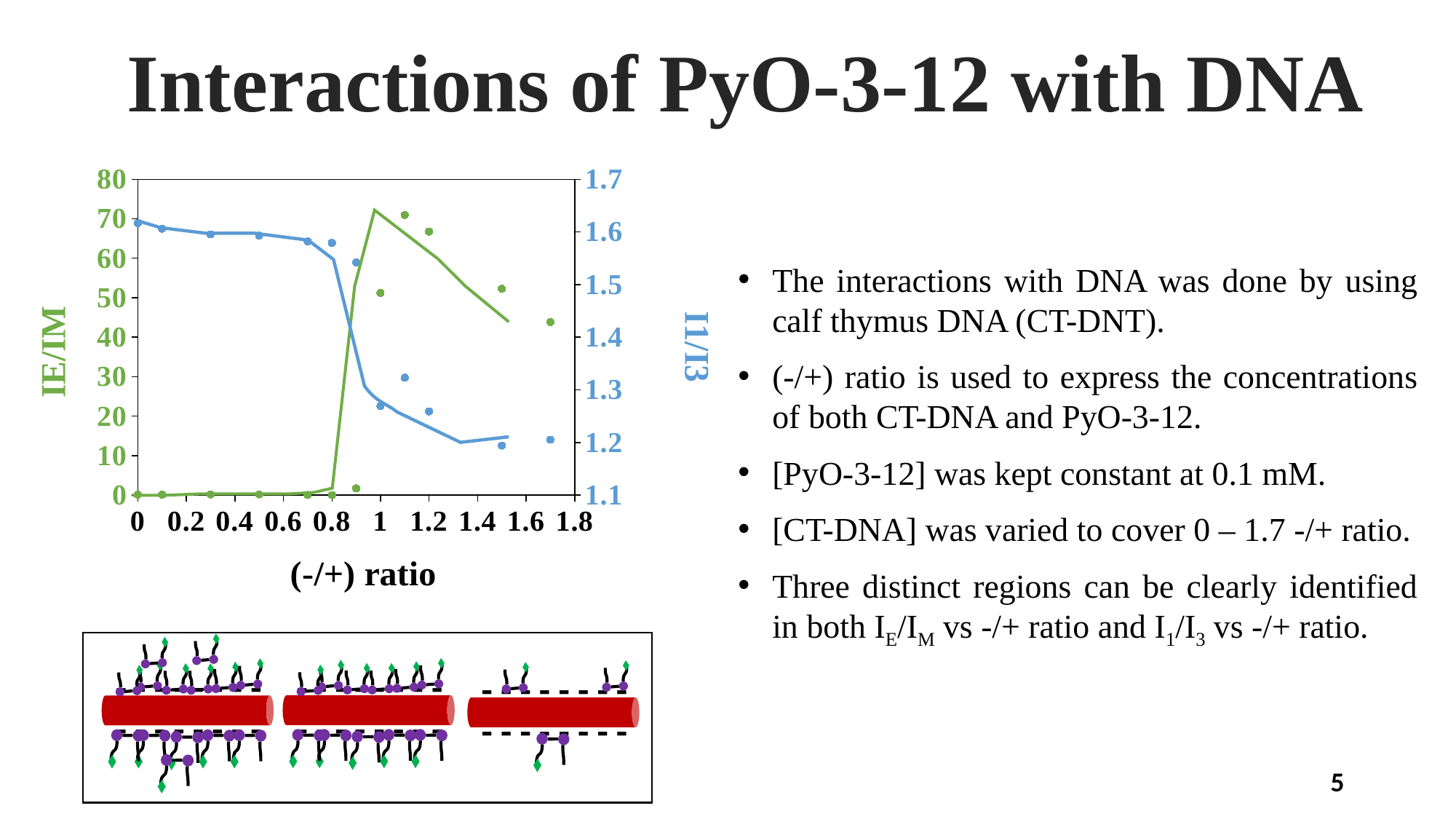
Which is larger, the IE/IM value at a (-/+) ratio of 1.1 or at 1.7? 1.1 Which is larger, the I1/I3 value at a (-/+) ratio of 0 or at 1.0? 0 How many data series are plotted on the chart? 2 Is the I1/I3 value at a (-/+) ratio of 0 greater or less than 1.5? greater Is the IE/IM value at a (-/+) ratio of 1.1 greater or less than 60? greater Does the I1/I3 series rise or fall as the (-/+) ratio increases from 0 to 1.7? fall What is the label of the x axis of the chart? (-/+) ratio What kind of chart is shown on the slide? Scatter chart with fitted lines Is the IE/IM value at a (-/+) ratio of 0.5 greater or less than 10? less What is the label of the right-hand y axis of the chart? I1/I3